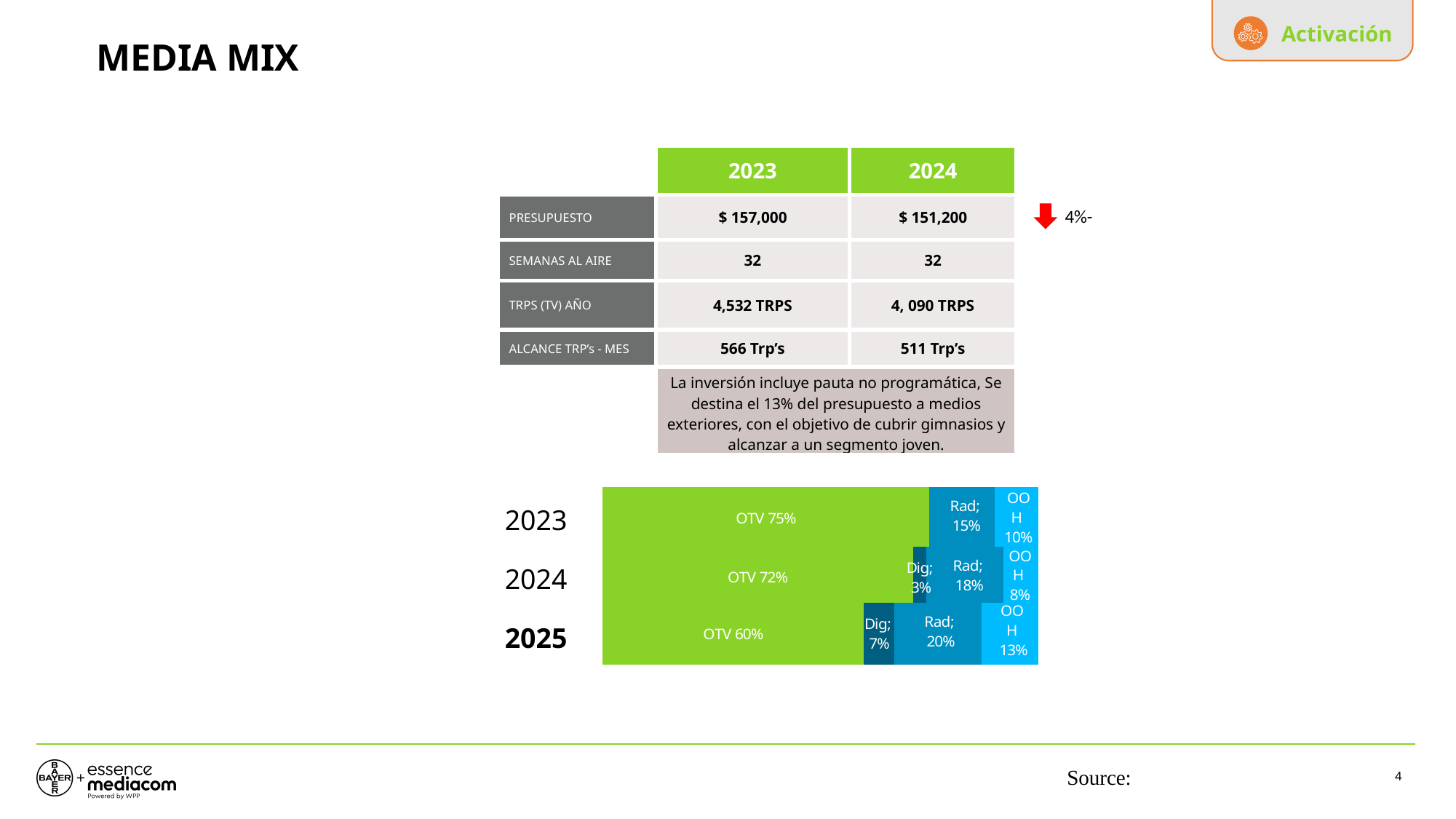
In the media mix bar chart, is the OOH share larger in 2025 or in 2024? 2025 In the media mix bar chart, what is the OOH share for 2024? 8% How many years (bars) are shown in the media mix bar chart? 3 In the media mix bar chart, what is the Dig share for 2025? 7% What kind of chart is shown at the bottom of the slide? Stacked bar chart In the media mix bar chart, which year has the lowest Rad share? 2023 In the media mix bar chart, does the OTV share rise or fall from 2023 to 2025? Fall In the media mix bar chart, what is the combined share of Dig and Rad in 2025? 27% In the media mix bar chart, which year has the highest OTV share? 2023 In the media mix bar chart, what is the Rad share for 2024? 18% In the media mix bar chart, what is the difference between the OTV share in 2023 and in 2025? 15% In the media mix bar chart, what is the OTV share for 2023? 75%